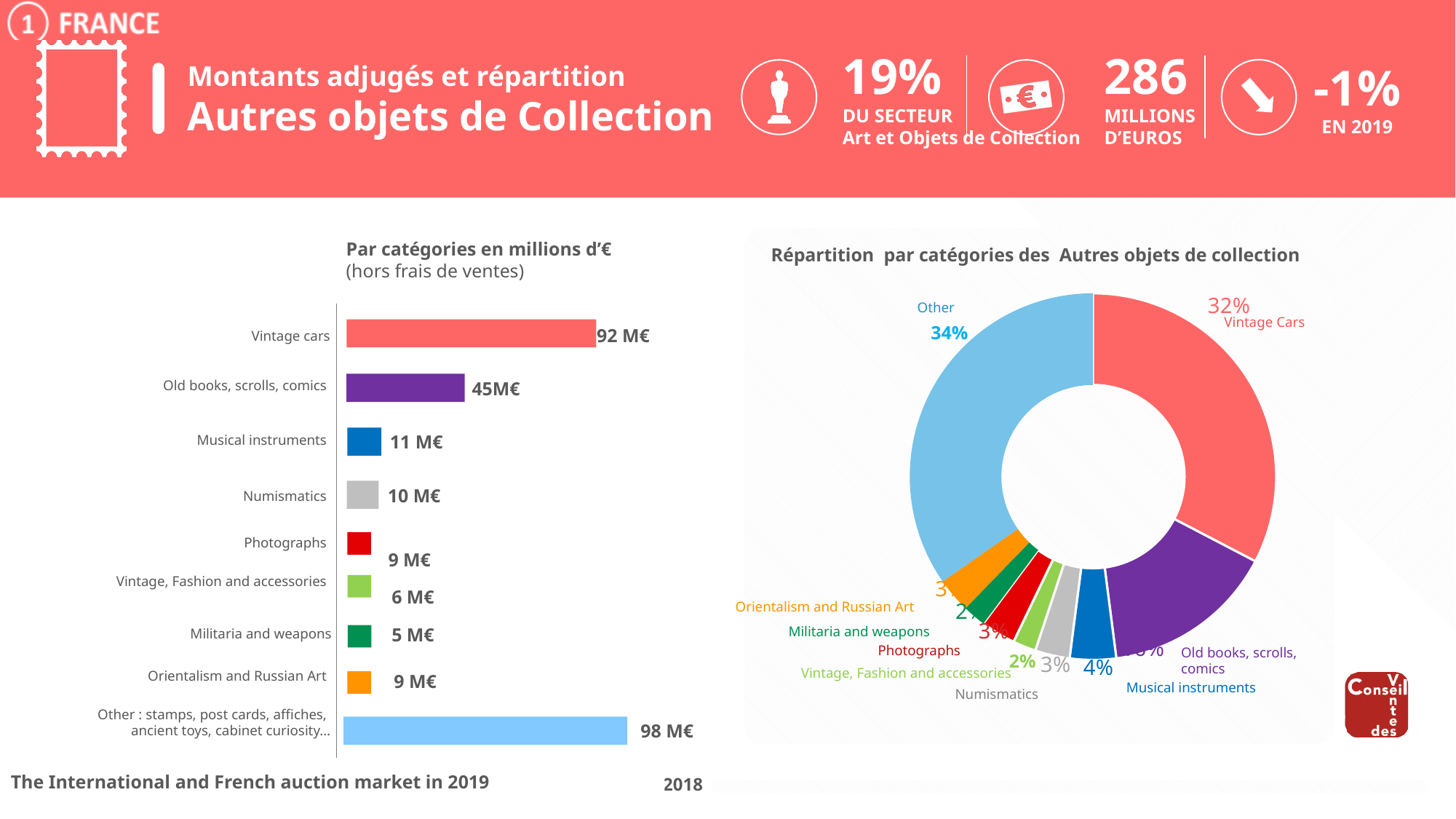
In the bar chart 'Par catégories en millions d'€', which category has the lowest value? Militaria and weapons In the donut chart 'Répartition par catégories des Autres objets de collection', what share does Other have? 34% In the bar chart 'Par catégories en millions d'€', which is larger: Musical instruments or Numismatics? Musical instruments In the donut chart 'Répartition par catégories des Autres objets de collection', what share does Vintage Cars have? 32% How many categories are shown in the bar chart 'Par catégories en millions d'€'? 9 In the bar chart 'Par catégories en millions d'€', what is the value for Militaria and weapons? 5 M€ In the bar chart 'Par catégories en millions d'€', what is the value for Vintage cars? 92 M€ What type of chart is 'Par catégories en millions d'€'? Bar chart In the bar chart 'Par catégories en millions d'€', what is the difference between Vintage cars and Old books, scrolls, comics? 47 M€ In the bar chart 'Par catégories en millions d'€', which category has the highest value? Other : stamps, post cards, affiches, ancient toys, cabinet curiosity... In the bar chart 'Par catégories en millions d'€', what is the value for Old books, scrolls, comics? 45M€ In the donut chart 'Répartition par catégories des Autres objets de collection', what share does Musical instruments have? 4%